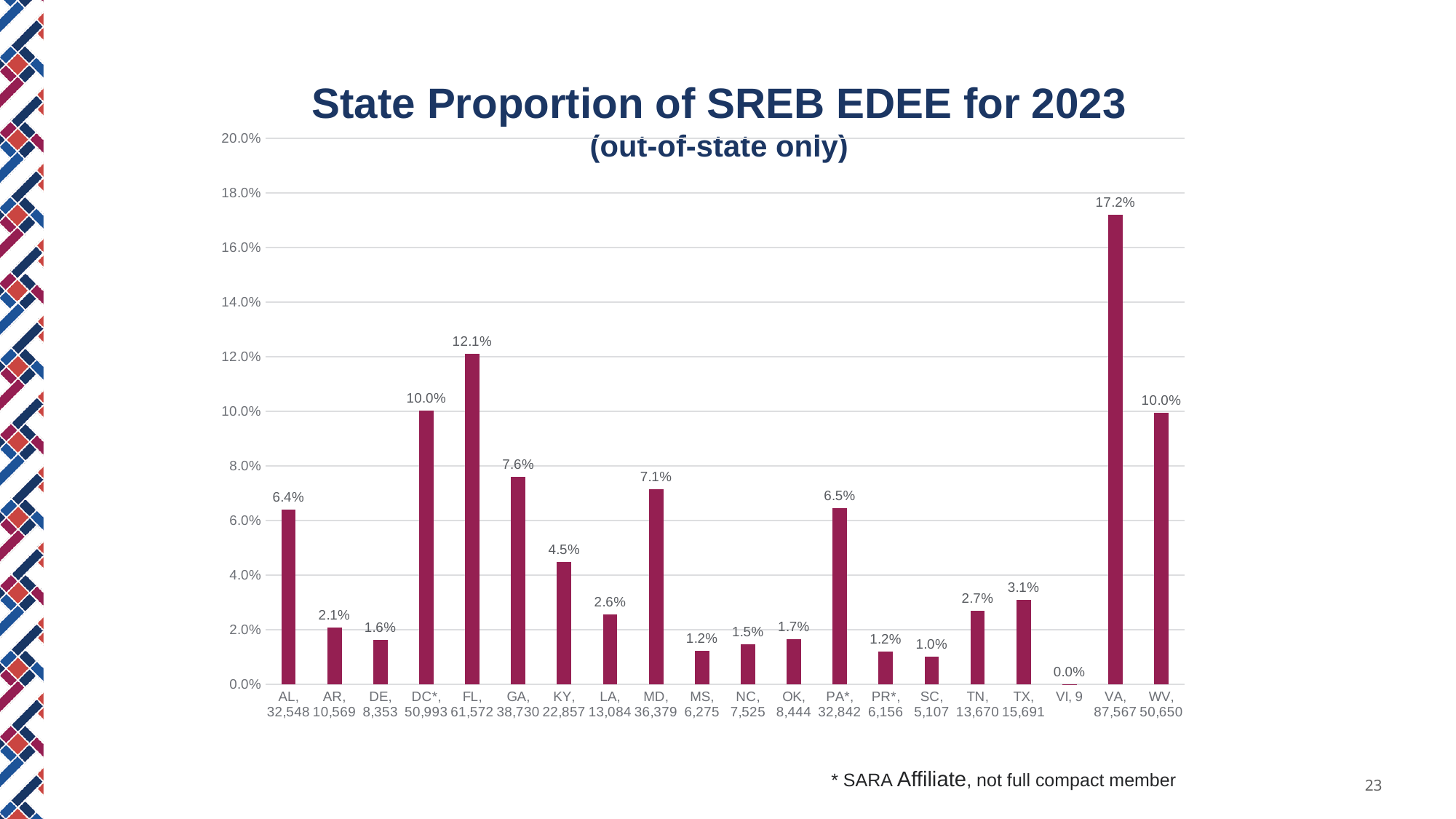
What number is shown with AL in its x-axis label? 32,548 What is the value for VA? 17.2% What is the title of the chart? State Proportion of SREB EDEE for 2023 (out-of-state only) Which category has the lowest value? VI What is the difference between the values for FL and DC*? 2.1% Which state has the highest proportion? VA What is the difference between the values for VA and WV? 7.2% What kind of chart is this? Bar chart What is the value for FL? 12.1% Which is larger, the value for GA or the value for MD? GA How many categories are shown on the x axis? 20 What is the value for PA*? 6.5%